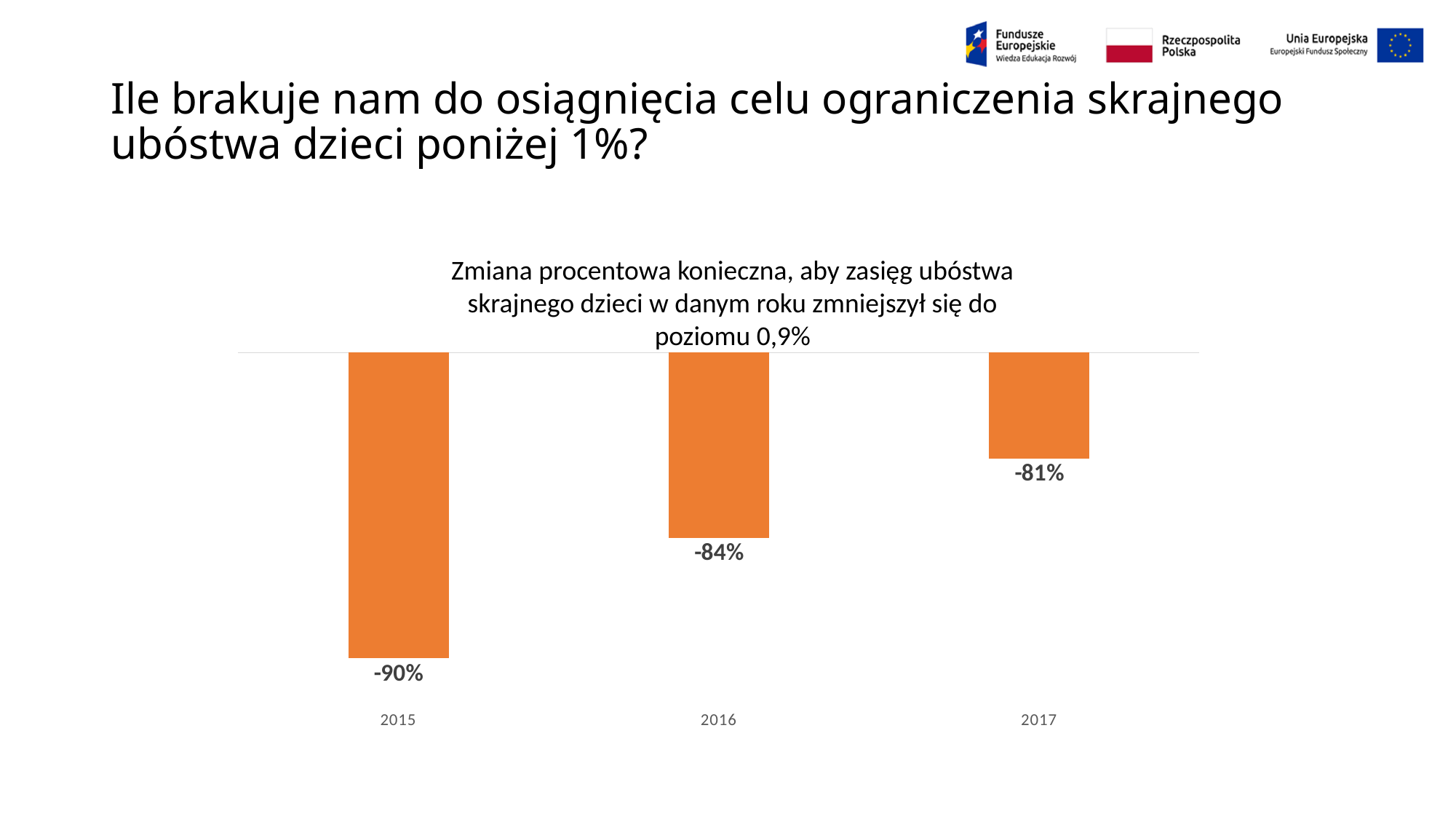
What colour are the bars in the chart? Orange Which year has the lowest (most negative) value? 2015 What is the difference between the values for 2015 and 2017? 9 percentage points What is the difference between the values for 2016 and 2017? 3 percentage points How many years are shown on the chart? 3 What is the value for 2016? -84% What type of chart is shown? Bar chart What is the value for 2015? -90% What is the value for 2017? -81% Which bar is longer, 2015 or 2016? 2015 Do the values rise or fall from 2015 to 2017? Rise Which year has the highest (least negative) value? 2017